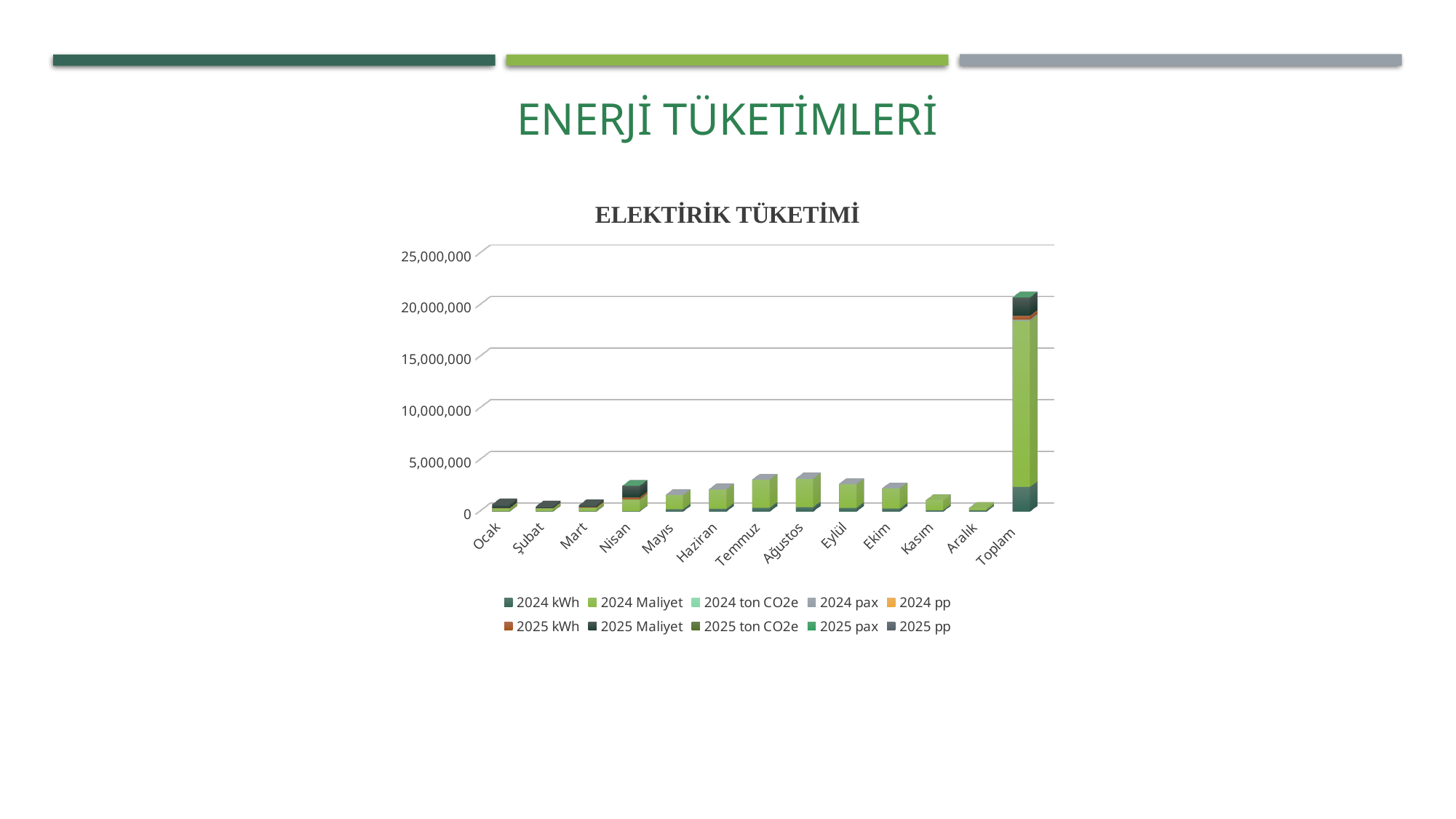
Which bar is taller, Toplam or Temmuz? Toplam Do the bar totals rise or fall from Ağustos to Aralık? fall How many categories are shown on the x axis of the chart? 13 Is the total value for Toplam greater or less than 15,000,000? greater Which bar is taller, Ağustos or Ocak? Ağustos Which category has the tallest bar in the chart? Toplam What is the title of the chart? ELEKTİRİK TÜKETİMİ What kind of chart is shown on the slide? bar chart Is the total value for Ağustos greater or less than 5,000,000? less How many series does the chart's legend list? 10 What is the highest value shown on the chart's vertical axis? 25,000,000 Is the total value for Aralık greater or less than 5,000,000? less